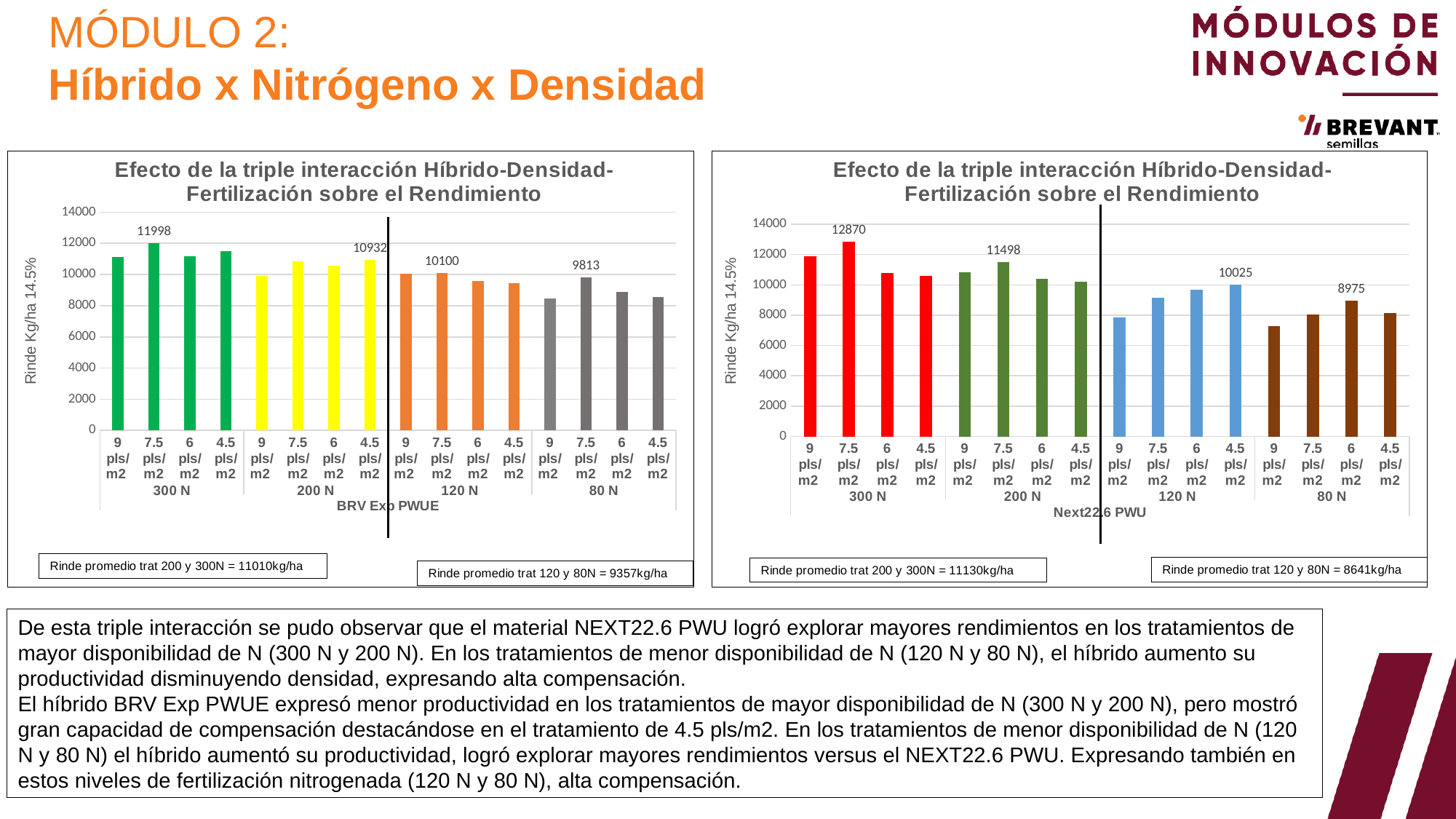
In the right chart (Next22.6 PWU), what is the difference between the labelled yields for 7.5 pls/m2 at 300 N and 7.5 pls/m2 at 200 N? 1372 In the right chart (Next22.6 PWU), is the value for 9 pls/m2 at 80 N greater or less than 8000? less In the left chart (BRV Exp PWUE), what is the yield for 7.5 pls/m2 at 300 N? 11998 Which is larger: the labelled yield for 7.5 pls/m2 at 300 N in the left chart or in the right chart? Right chart (12870) In the right chart (Next22.6 PWU), which density and nitrogen treatment has the highest yield? 7.5 pls/m2 at 300 N How many bars are plotted in the left chart (BRV Exp PWUE)? 16 In the left chart (BRV Exp PWUE), what is the difference between the labelled yields for 7.5 pls/m2 at 300 N and 4.5 pls/m2 at 200 N? 1066 In the left chart (BRV Exp PWUE), what is the yield for 4.5 pls/m2 at 200 N? 10932 In the right chart (Next22.6 PWU), what is the yield for 7.5 pls/m2 at 300 N? 12870 In the right chart (Next22.6 PWU), what is the yield for 6 pls/m2 at 80 N? 8975 In the left chart (BRV Exp PWUE), is the value for 9 pls/m2 at 300 N greater or less than 10000? greater What kind of chart is the right chart (Next22.6 PWU)? Bar chart